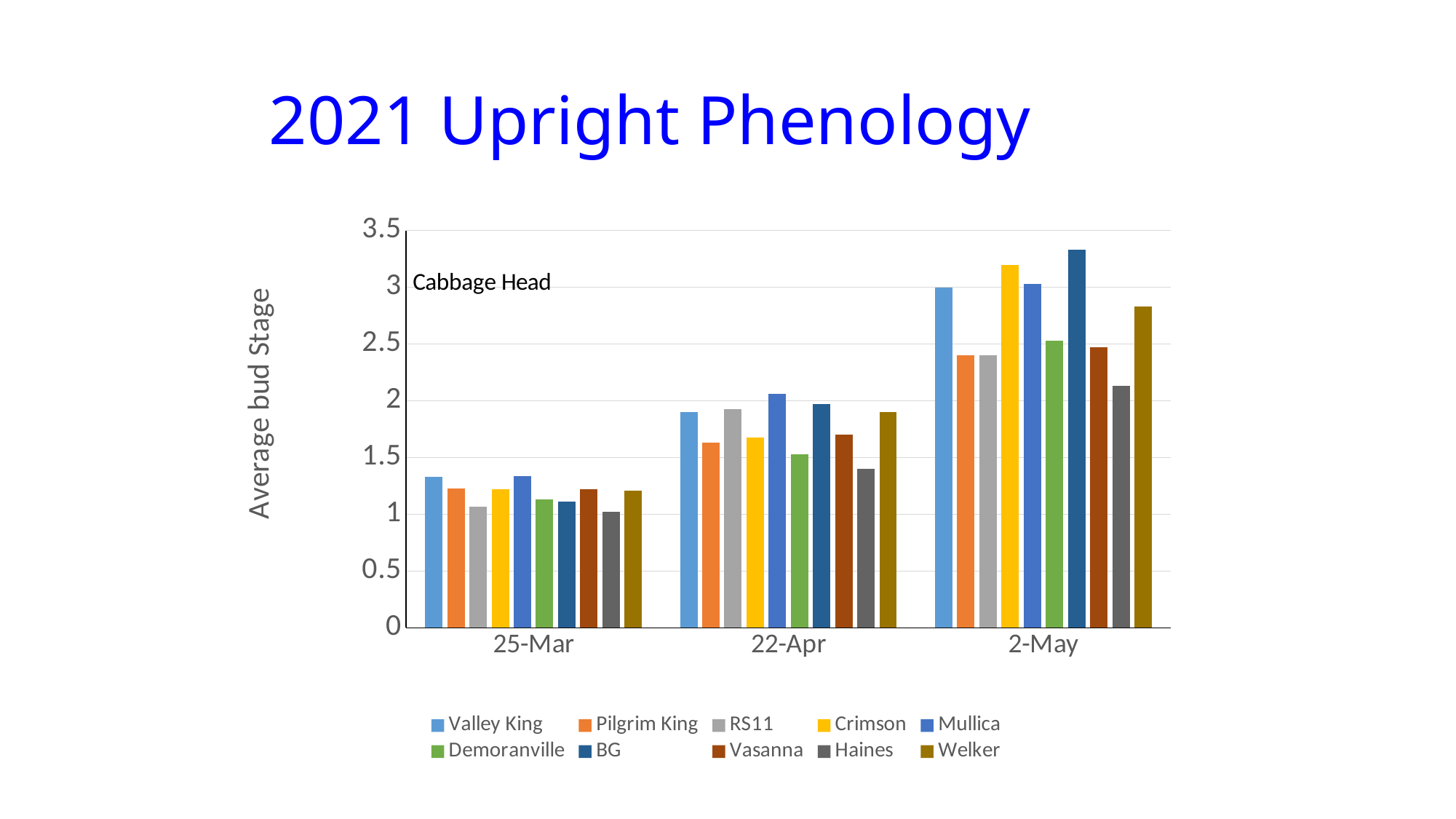
On 22-Apr, which is larger: the value for Valley King or the value for Pilgrim King? Valley King What kind of chart is shown on the slide? bar chart Which variety has the lowest average bud stage on 22-Apr? Haines Which variety has the lowest average bud stage on 2-May? Haines Which variety has the highest average bud stage on 2-May? BG How many dates are shown on the x axis? 3 Is the value for BG on 2-May greater or less than 3? greater What is the label on the y axis? Average bud Stage Is the value for Pilgrim King on 2-May greater or less than 2.5? less How many series does the legend list? 10 Is the value for Haines on 22-Apr greater or less than 1.5? less Does the average bud stage for Valley King rise or fall from 25-Mar to 2-May? rise